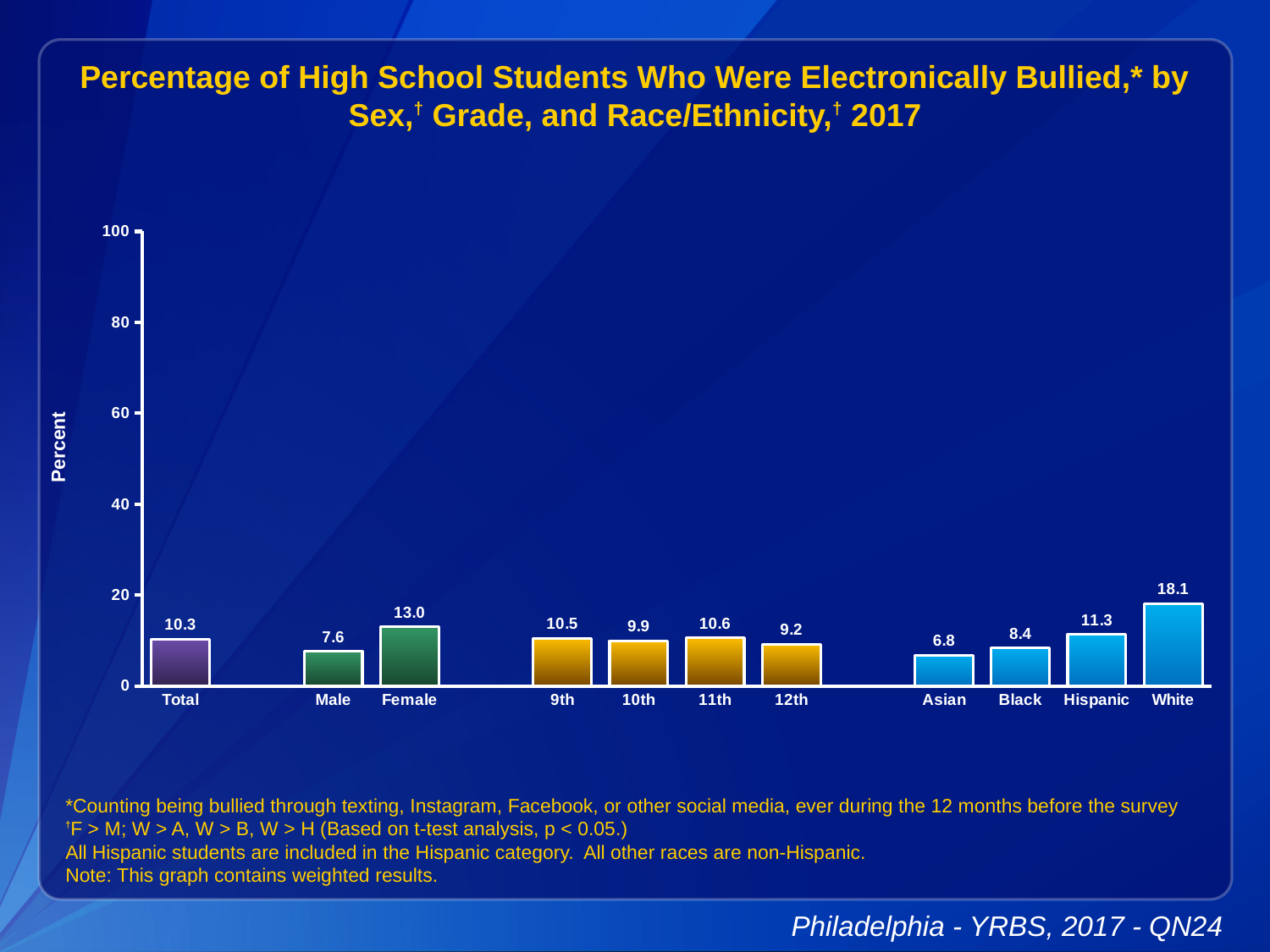
Which category has the highest value? White How many categories are shown on the x axis? 11 What is the value for Total? 10.3 What is the value for Hispanic? 11.3 Is the value for White greater or less than 20? less What kind of chart is this? bar chart Which category has the lowest value? Asian Which is larger, the value for 9th grade or the value for 12th grade? 9th What is the value for 11th grade? 10.6 What is the label on the y axis? Percent What is the difference between the values for Female and Male? 5.4 What is the value for Female? 13.0